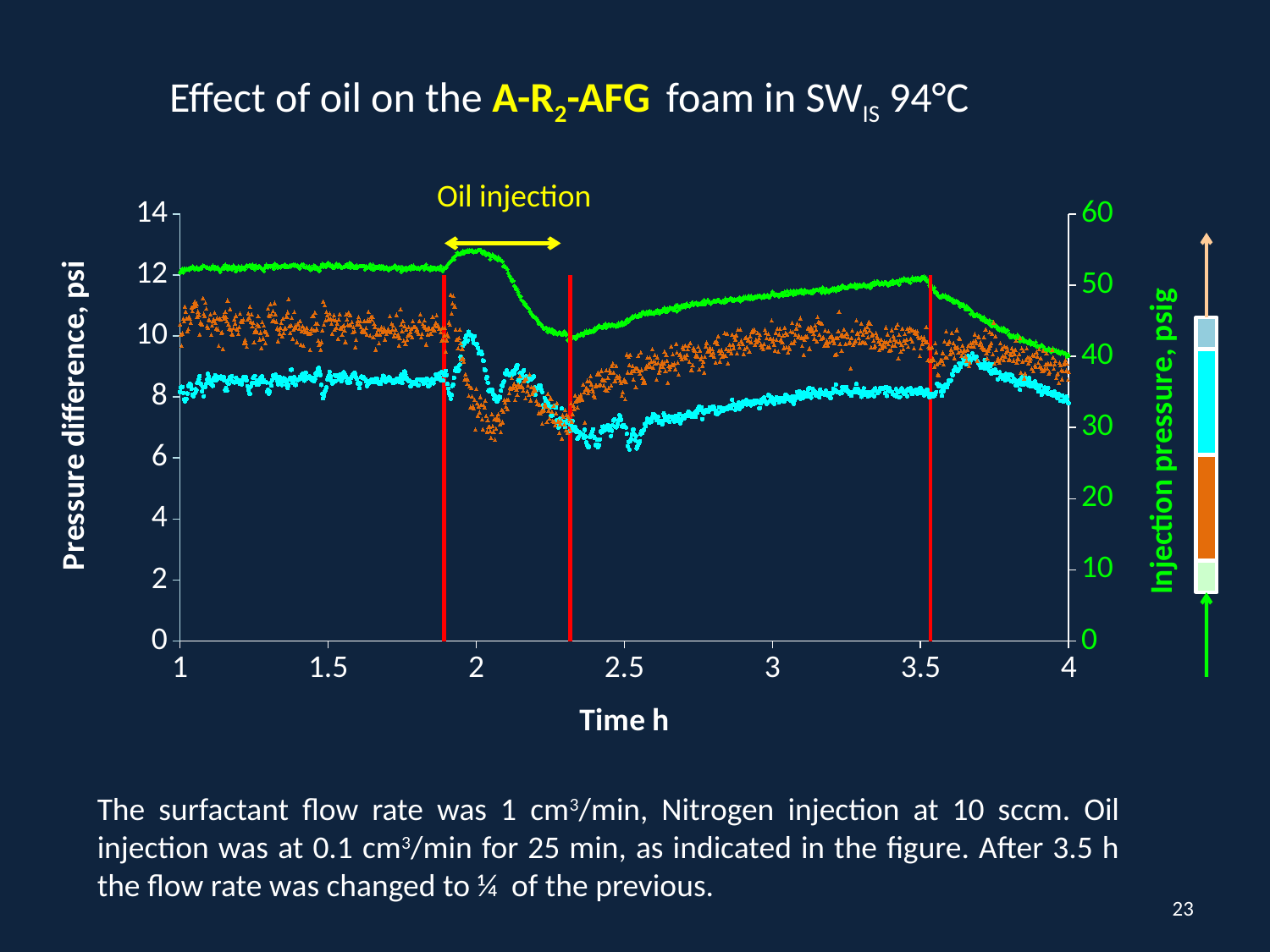
Is the value of the orange series at 3 h greater or less than 8 psi? greater What is the label of the left vertical axis of the chart? Pressure difference, psi Is the value of the green series (Injection pressure) at 1.5 h greater or less than 50 psig? greater What is the maximum value shown on the left vertical axis (Pressure difference, psi)? 14 How many data series are plotted on the chart? 3 What is the range of the Time h axis on the chart? 1 to 4 What is the title of the chart on the slide? Effect of oil on the A-R2-AFG foam in SWIS 94°C Does the green series rise or fall between 2.5 h and 3.5 h? rise What kind of chart is shown on the slide? scatter chart Is the value of the cyan series at 1.5 h greater or less than 10 psi? less What is the maximum value shown on the right vertical axis (Injection pressure, psig)? 60 Does the cyan series rise or fall between 2 h and 2.4 h? fall